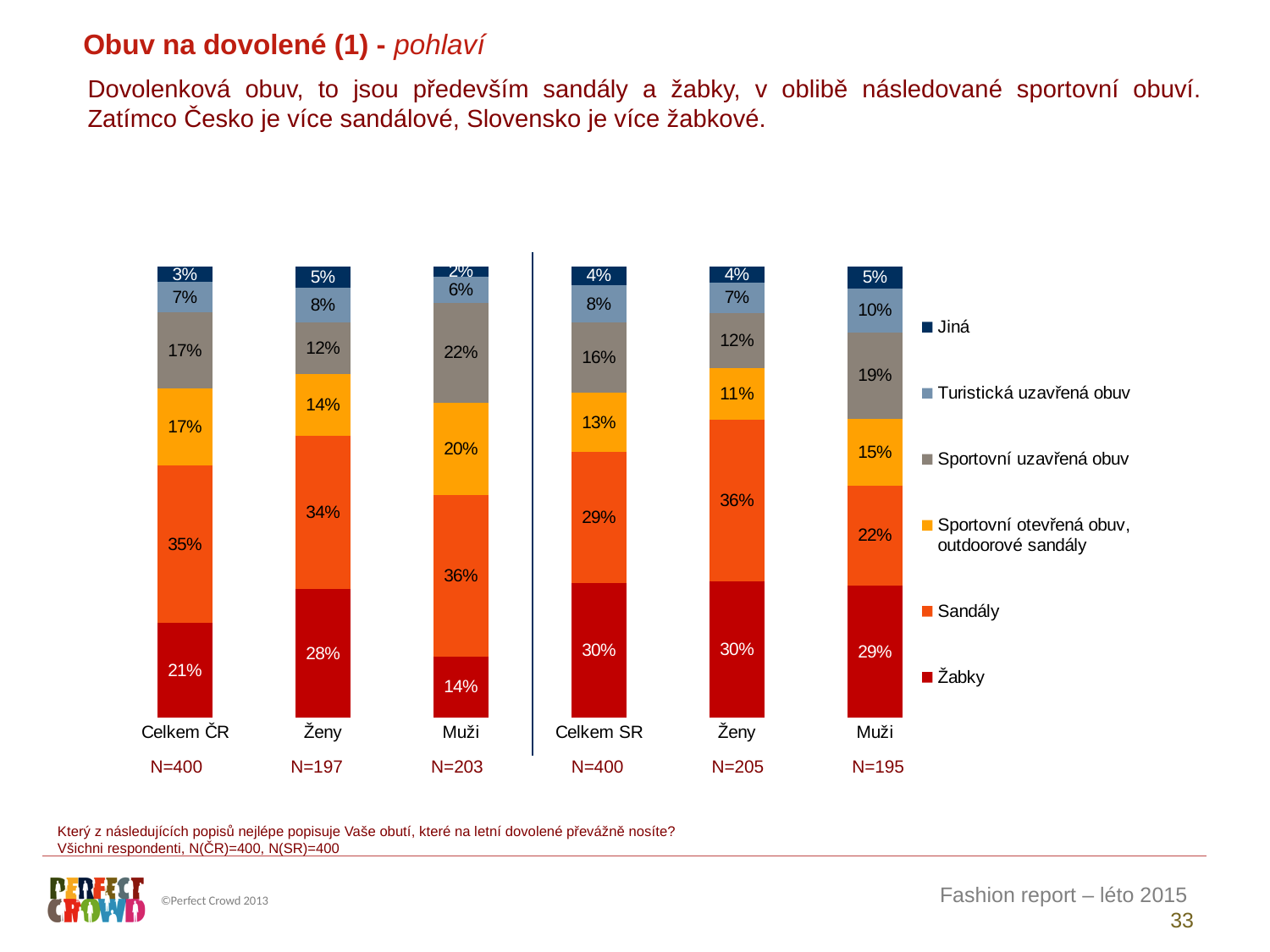
What is the sample size (N) shown under the Muži bar in the SR group? N=195 Which is larger: the Sportovní otevřená obuv value for Ženy in the ČR group or for Ženy in the SR group? Ženy in the ČR group (14%) How many series does the legend list? 6 How many bars (categories) are plotted in the chart? 6 What is the difference between the Sandály value for Celkem ČR and for Celkem SR? 6 percentage points Which bar has the lowest value for Žabky? Muži (ČR) Which bar has the highest value for Žabky? Celkem SR and Ženy (SR), both 30% What is the value of Sportovní uzavřená obuv for Muži in the ČR group (left of the divider)? 22% What is the value of Sandály for Celkem ČR? 35% What is the value of Turistická uzavřená obuv for Muži in the SR group (right of the divider)? 10% What type of chart is shown on the slide? Stacked bar chart What is the value of Žabky for Celkem SR? 30%